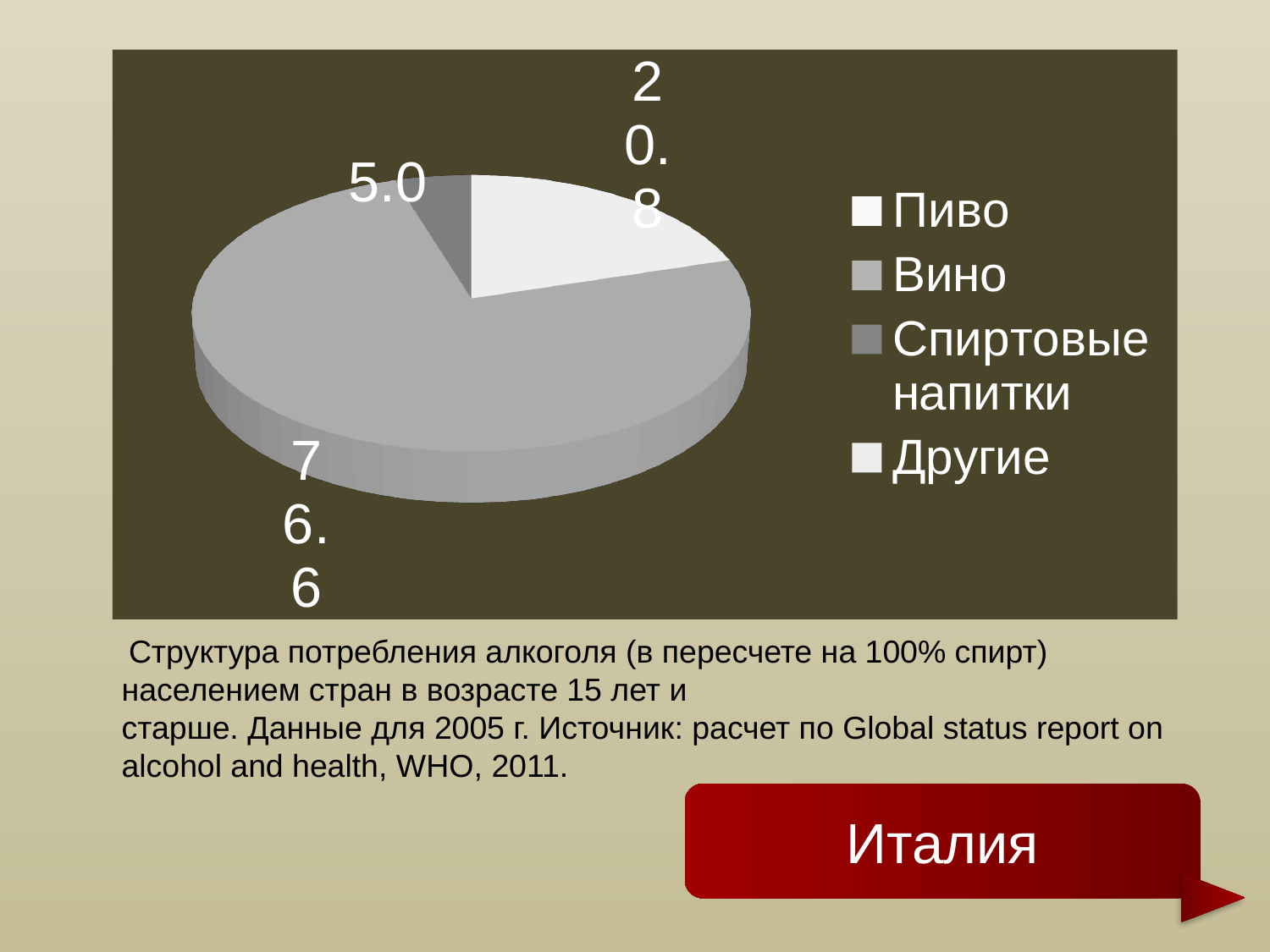
Which is larger in the pie chart, Вино or Пиво? Вино Which category has the largest slice in the pie chart? Вино What is the difference between the Вино value and the Пиво value in the pie chart? 55.8 Which country does the chart on the slide refer to? Италия How many entries does the legend of the pie chart list? 4 What is the difference between the Пиво value and the Спиртовые напитки value in the pie chart? 15.8 What value is shown for the Пиво slice of the pie chart? 20.8 For which year are the data in the chart given, according to the caption? 2005 Which is larger in the pie chart, the Пиво slice or the Спиртовые напитки slice? Пиво What value is shown for the Вино slice of the pie chart? 76.6 What kind of chart is shown on the slide? Pie chart What value is shown for the Спиртовые напитки slice of the pie chart? 5.0